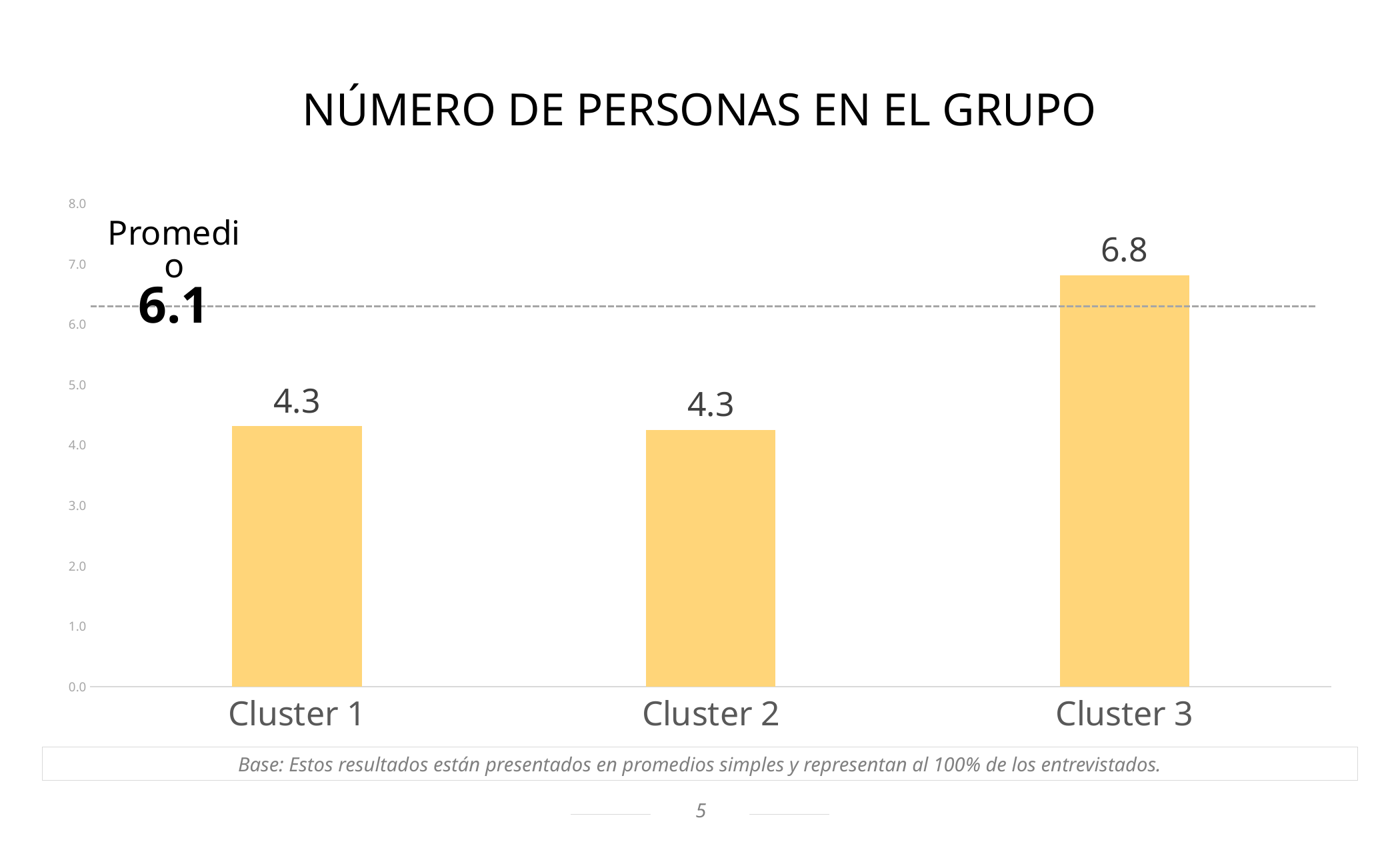
Which is larger, the value for Cluster 3 or the value for Cluster 2? Cluster 3 What is the average (Promedio) value marked by the dashed line on the chart? 6.1 What is the title of the chart? NÚMERO DE PERSONAS EN EL GRUPO What is the difference between the values for Cluster 3 and Cluster 1? 2.5 Which cluster has the highest number of people in the group? Cluster 3 What is the value for Cluster 3? 6.8 What is the value for Cluster 1? 4.3 How many clusters are shown on the chart? 3 Is the value for Cluster 1 greater or less than 5.0? less What kind of chart is shown on the slide? Bar chart Is the value for Cluster 3 greater or less than 6.0? greater What is the value for Cluster 2? 4.3